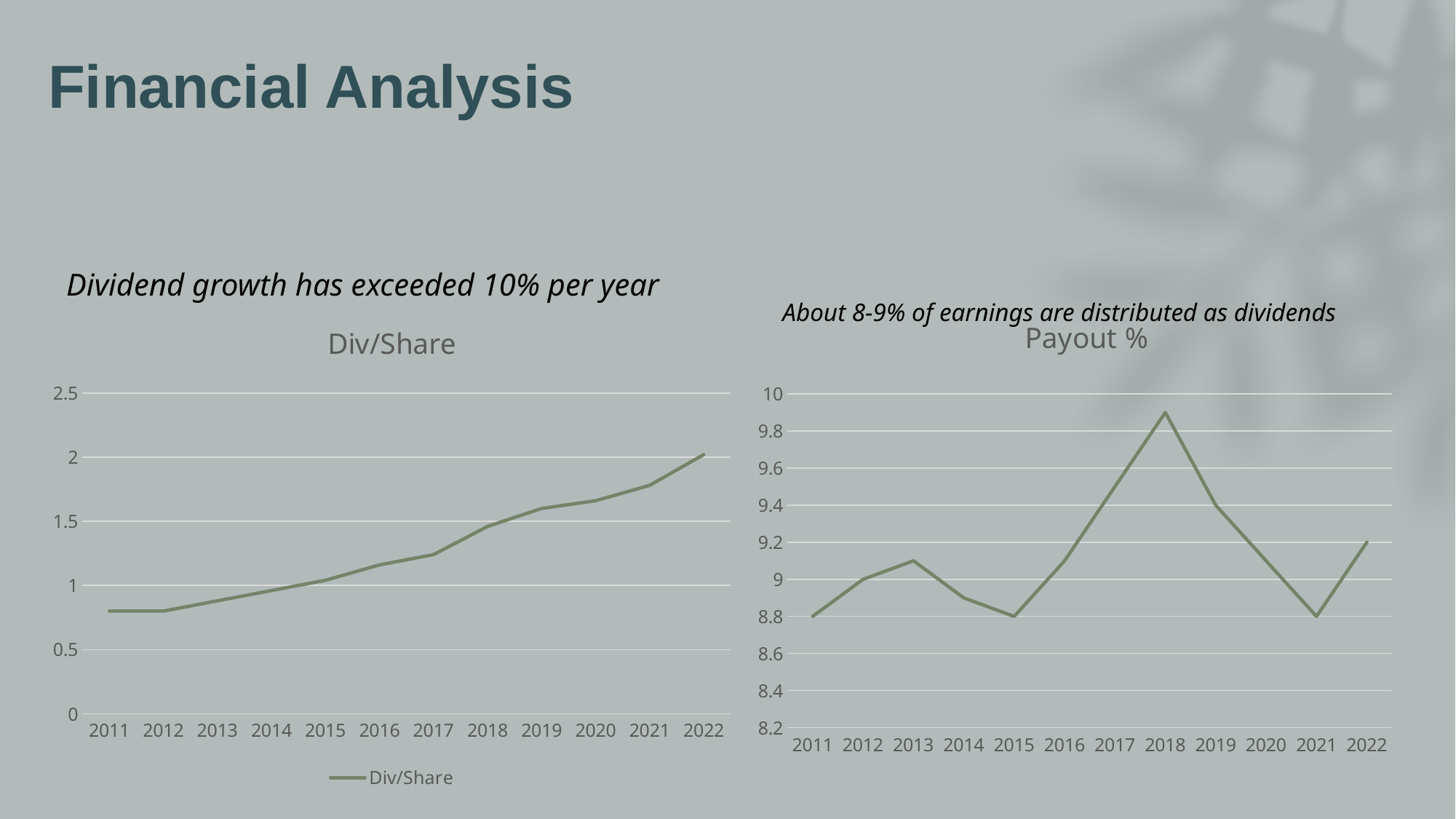
What kind of chart is the Div/Share chart on the left? line chart In the Div/Share chart, is the value for 2022 greater or less than 1.5? greater In the Payout % chart, which is larger, the value for 2018 or the value for 2021? 2018 In the Div/Share chart, which year has the highest value? 2022 In the Payout % chart, which year has the highest value? 2018 What is the title of the chart on the right side of the slide? Payout % How many series does the legend of the Div/Share chart list? 1 In the Div/Share chart, do the values generally rise or fall from 2011 to 2022? rise In the Payout % chart, is the value for 2018 greater or less than 9.8? greater In the Div/Share chart, is the value for 2011 greater or less than 1? less In the Div/Share chart, how many years are plotted along the x axis? 12 In the Payout % chart, what is the value for 2022? 9.2